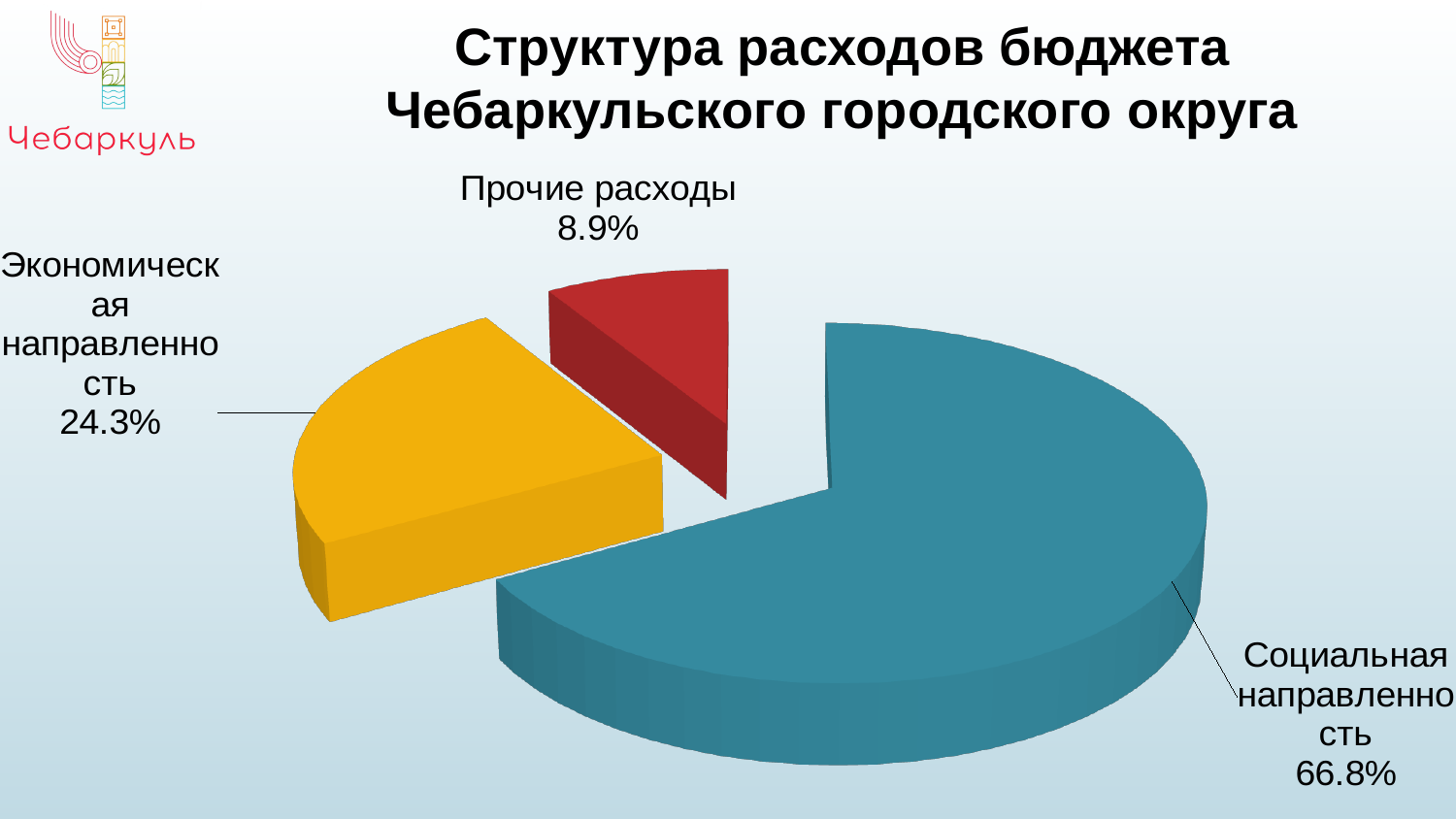
What is the value shown for Экономическая направленность? 24.3% Which is larger, Экономическая направленность or Прочие расходы? Экономическая направленность What is the value shown for Прочие расходы? 8.9% What is the title of the chart? Структура расходов бюджета Чебаркульского городского округа What colour is the slice for Прочие расходы? Red Which category has the smallest slice of the pie? Прочие расходы What kind of chart is shown on the slide? Pie chart What is the difference in percentage points between Экономическая направленность and Прочие расходы? 15.4 What share of the pie does Социальная направленность have? 66.8% Which category has the largest slice of the pie? Социальная направленность How many slices does the pie chart have? 3 What is the difference in percentage points between Социальная направленность and Экономическая направленность? 42.5